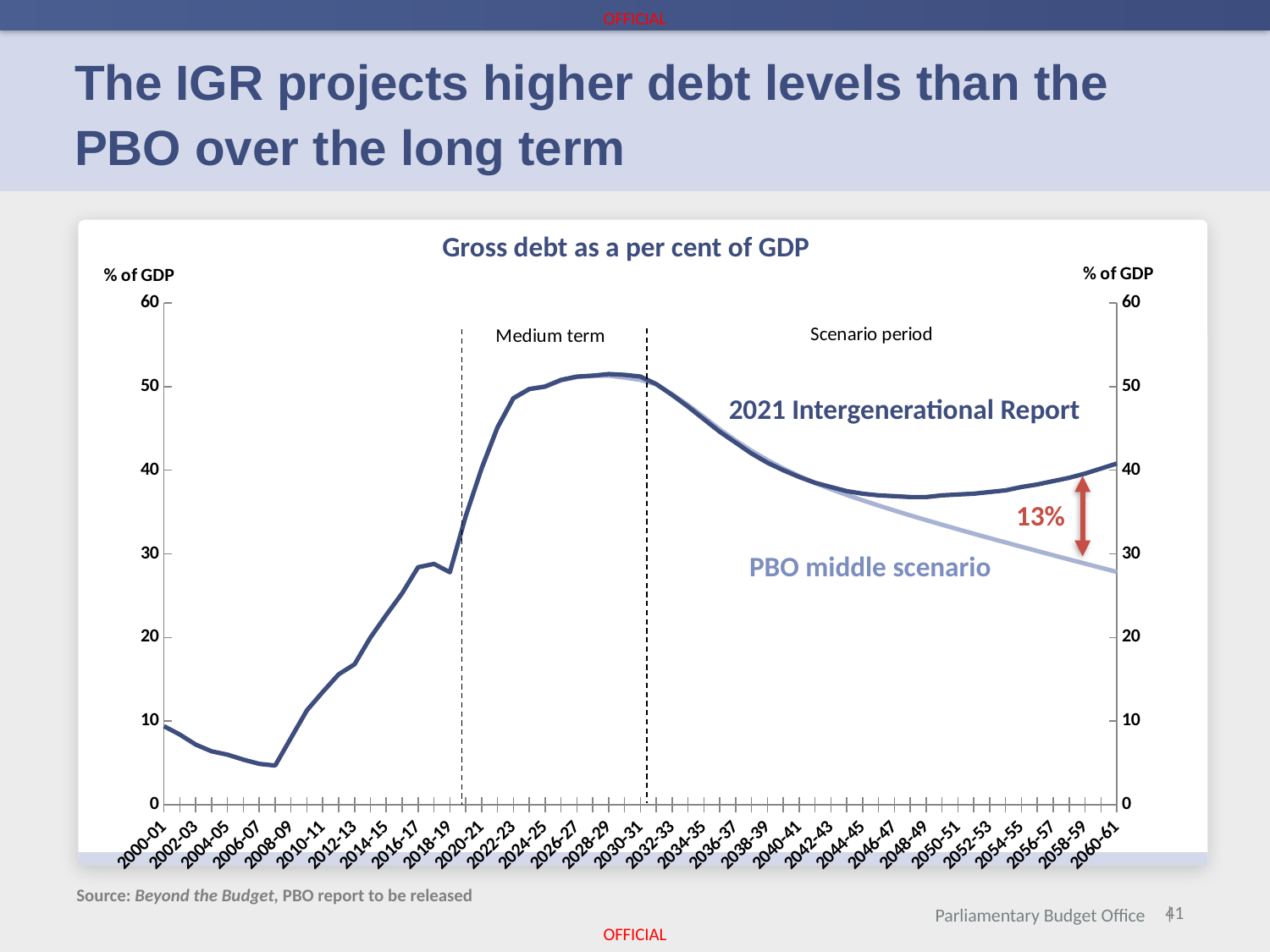
Is the value for 2028-29 greater or less than 50? greater In which year does gross debt as a per cent of GDP reach its lowest point? 2007-08 What are the names of the two series plotted on the chart? 2021 Intergenerational Report and PBO middle scenario Is the PBO middle scenario value for 2060-61 greater or less than 30? less How many series are plotted on the chart? 2 Is the 2021 Intergenerational Report value for 2048-49 greater or less than 40? less What kind of chart is shown on the slide? line chart What percentage gap between the two series is annotated at the end of the scenario period? 13% At 2060-61, which series shows the higher gross debt: the 2021 Intergenerational Report or the PBO middle scenario? 2021 Intergenerational Report Does the PBO middle scenario rise or fall over the scenario period from 2032-33 to 2060-61? fall What is the title of the chart? Gross debt as a per cent of GDP